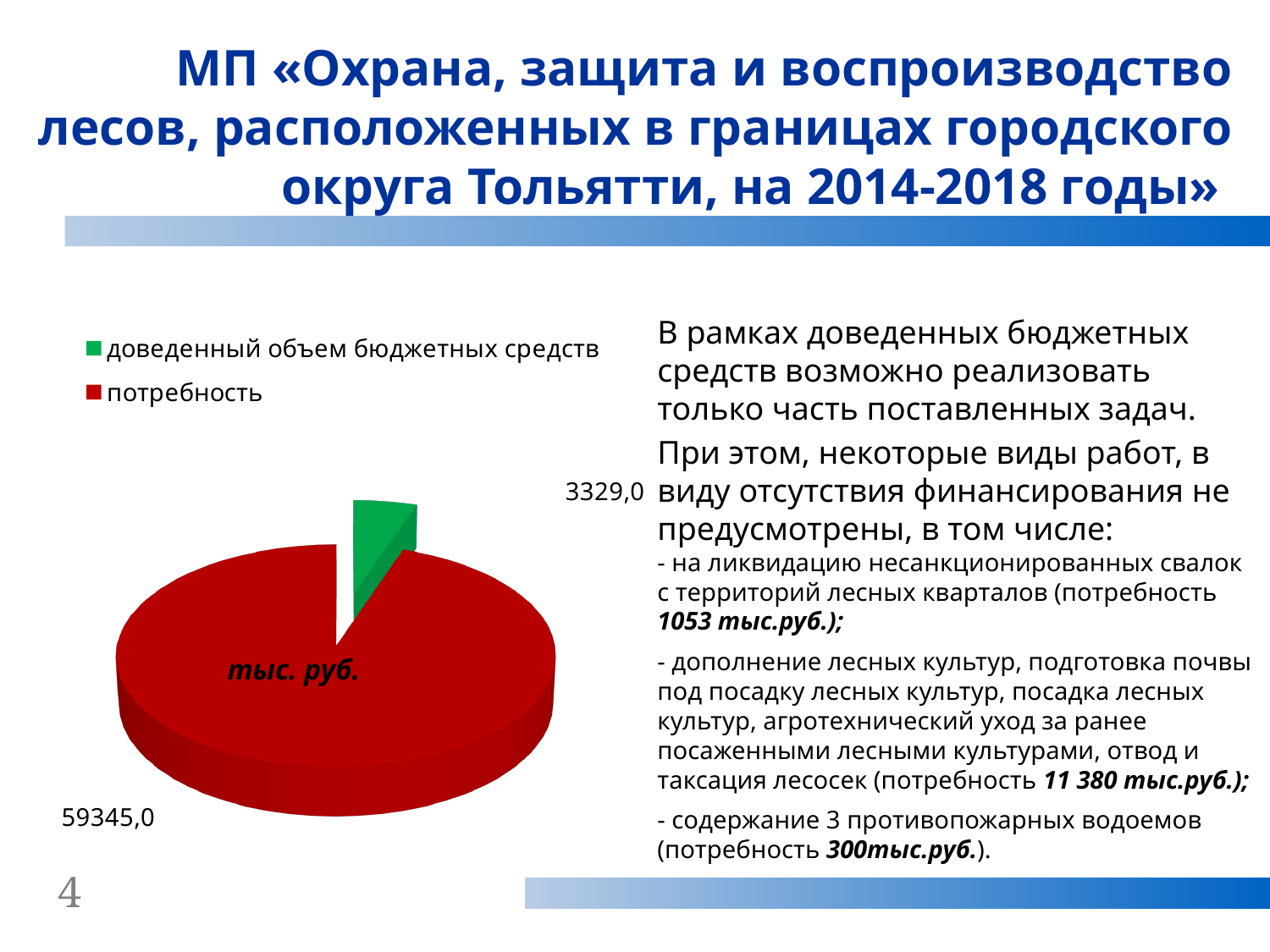
What type of chart is shown on the slide? Pie chart Which slice of the pie chart is the largest? потребность How many entries does the legend of the pie chart list? 2 What is the total of the two slices in the pie chart? 62674,0 What unit label is printed inside the pie chart? тыс. руб. Which is larger in the pie chart: «потребность» or «доведенный объем бюджетных средств»? потребность Which slice of the pie chart is the smallest? доведенный объем бюджетных средств How many slices does the pie chart have? 2 What is the value of the «потребность» slice in the pie chart? 59345,0 What is the difference between «потребность» and «доведенный объем бюджетных средств» in the pie chart? 56016,0 What is the value of the «доведенный объем бюджетных средств» slice in the pie chart? 3329,0 What colour is the «потребность» slice in the pie chart? Red